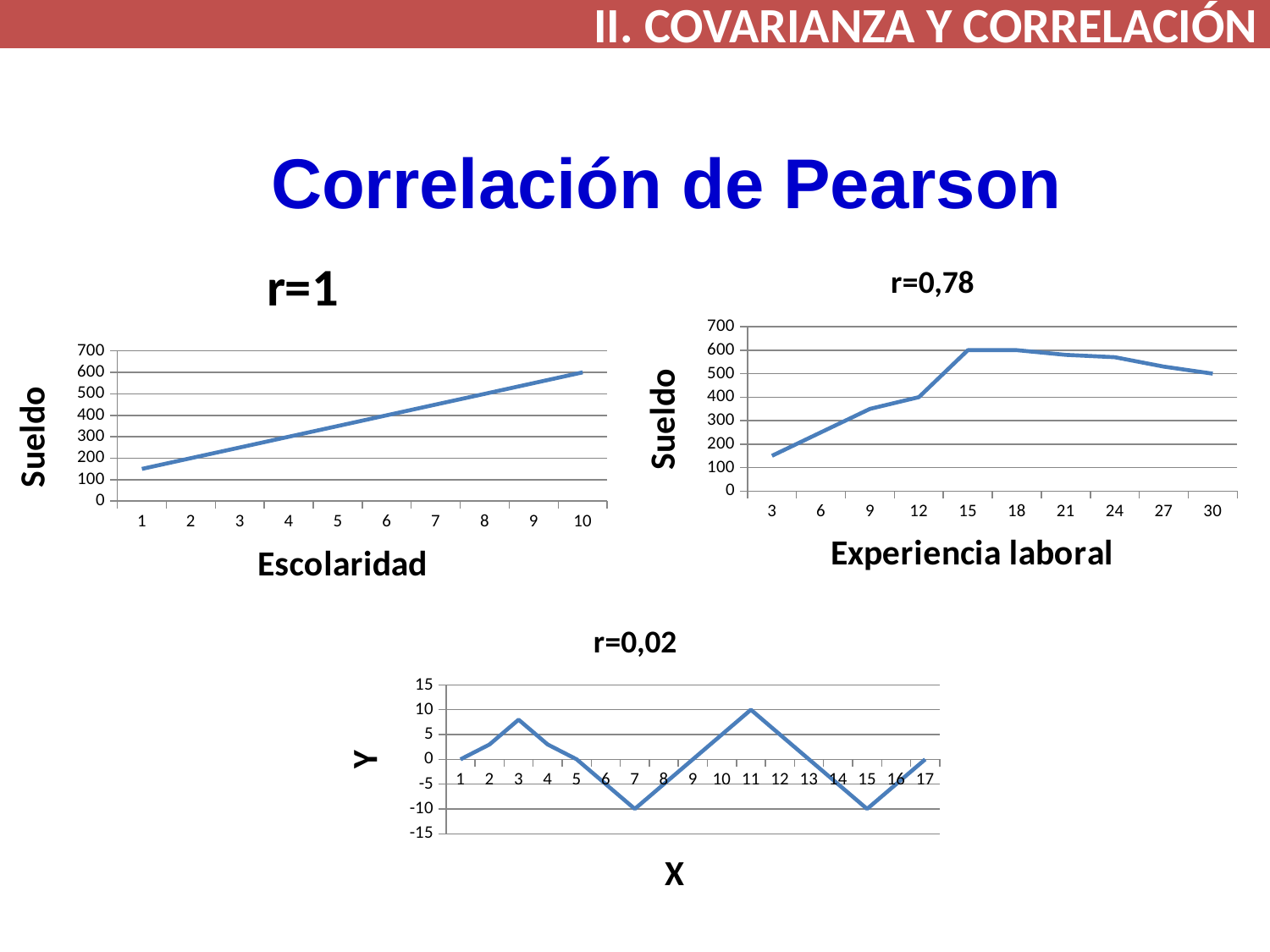
In the chart titled r=1, what is the x-axis title? Escolaridad In the chart titled r=0,02, what is the Y value at X = 11? 10 In the chart titled r=0,78, what is the Sueldo value at Experiencia laboral 30? 500 In the chart titled r=0,78, is the Sueldo value at Experiencia laboral 9 greater or less than 300? greater In the chart titled r=1, what is the Sueldo value at Escolaridad 10? 600 In the chart titled r=0,78, which Experiencia laboral value has the lowest Sueldo? 3 In the chart titled r=0,02, how many points are plotted along the X axis? 17 In the chart titled r=0,78, how many points are plotted along the x axis? 10 In the chart titled r=1, is the Sueldo value at Escolaridad 2 greater or less than 300? less In the chart titled r=1, do the values rise or fall as Escolaridad increases from 1 to 10? rise What kind of chart is the chart titled r=1? line chart In the chart titled r=0,02, which is larger, the Y value at X = 3 or at X = 7? X = 3